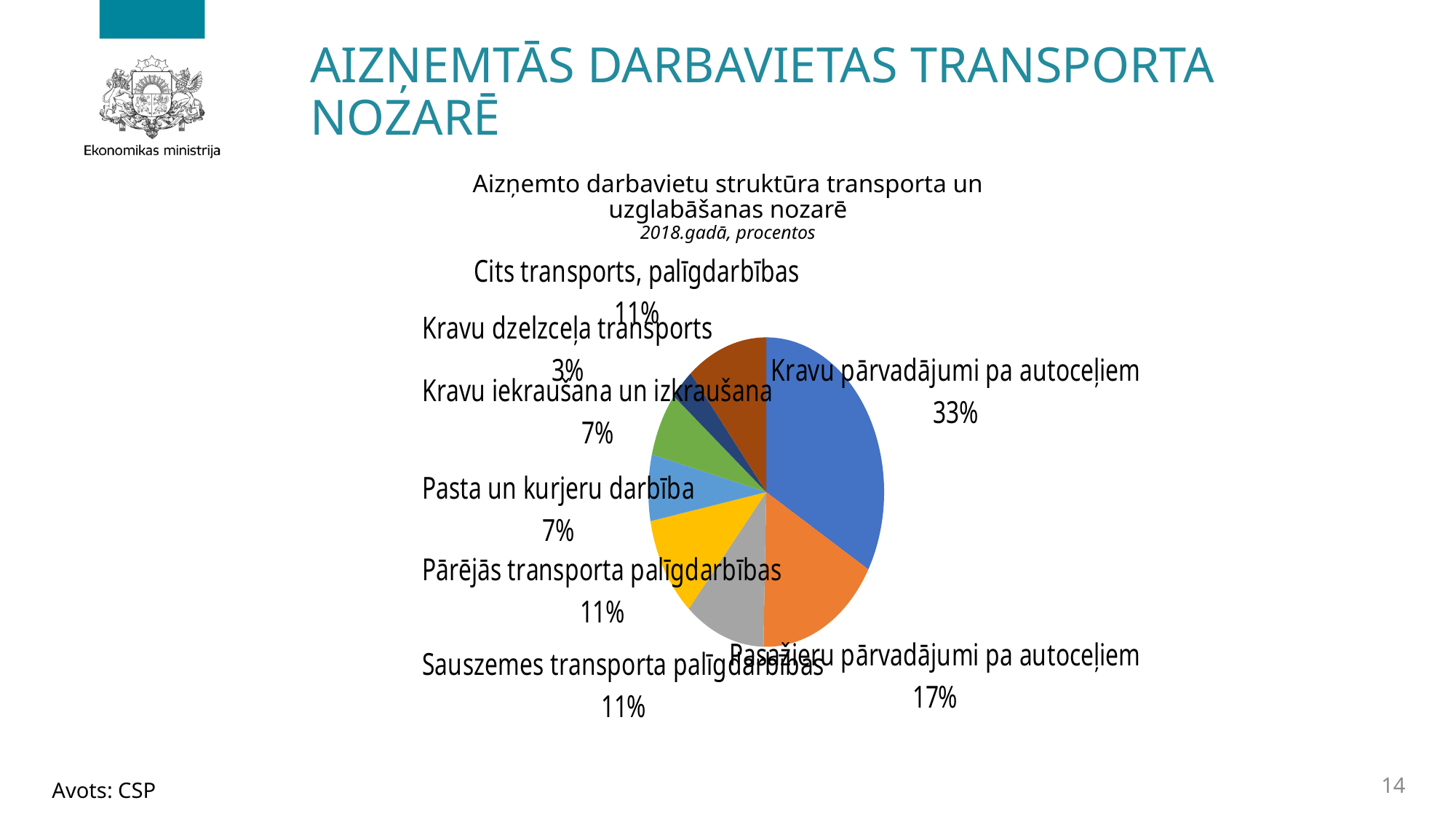
Which category has the smallest slice of the pie chart? Kravu dzelzceļa transports Which is larger: Kravu iekraušana un izkraušana or Kravu dzelzceļa transports? Kravu iekraušana un izkraušana What percentage is shown for Pasta un kurjeru darbība? 7% How many categories are shown in the pie chart? 8 What percentage is shown for Pasažieru pārvadājumi pa autoceļiem? 17% What percentage is shown for Kravu dzelzceļa transports? 3% What type of chart is shown on the slide? Pie chart What share of occupied jobs does Kravu pārvadājumi pa autoceļiem hold in the pie chart? 33% What is the difference in percentage points between Kravu pārvadājumi pa autoceļiem and Pasažieru pārvadājumi pa autoceļiem? 16 Which category has the largest slice of the pie chart? Kravu pārvadājumi pa autoceļiem What is the combined share of Sauszemes transporta palīgdarbības and Pārējās transporta palīgdarbības? 22% Which year does the chart subtitle say the data refers to? 2018